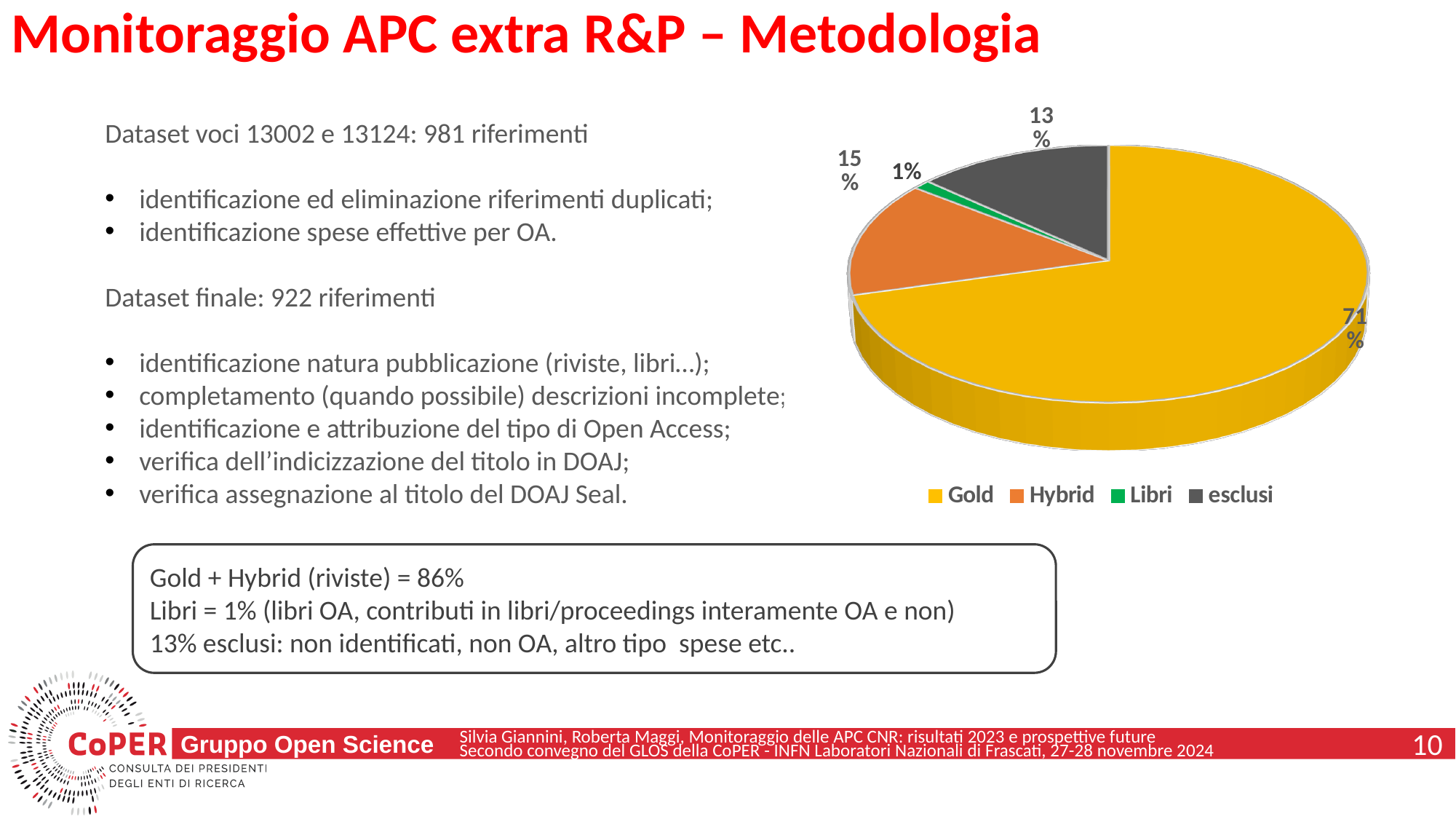
Which slice is larger, Hybrid or esclusi? Hybrid Which category has the smallest slice in the pie chart? Libri What kind of chart is shown on the slide? Pie chart What share of the pie chart does esclusi represent? 13% What share of the pie chart does Gold represent? 71% What share of the pie chart does Hybrid represent? 15% How many categories does the pie chart show? 4 What is the difference in percentage points between the Gold and Hybrid slices? 56% Which category has the largest slice in the pie chart? Gold What is the combined share of the Gold and Hybrid slices? 86% What colour is the Libri slice in the pie chart? Green